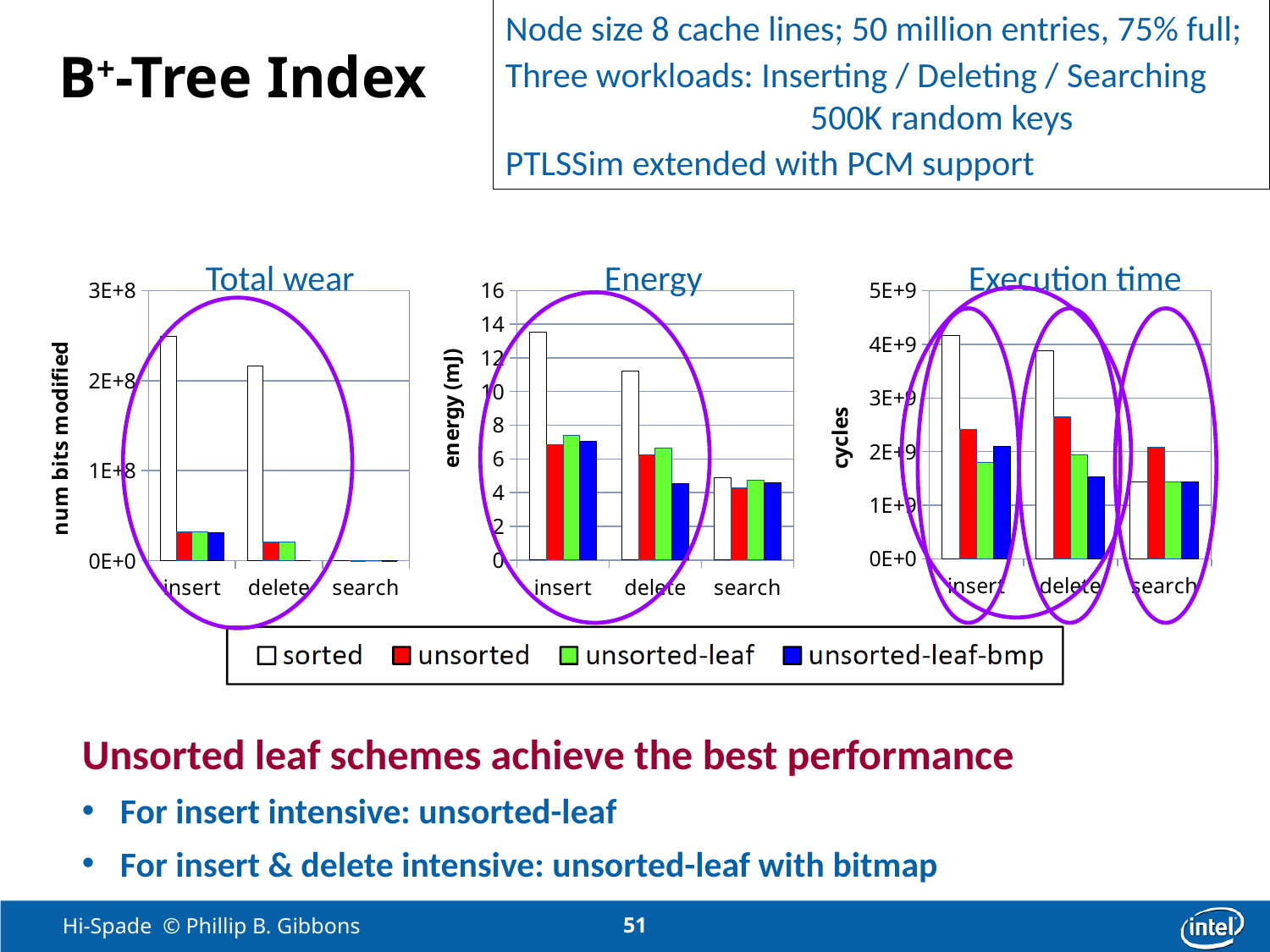
How many series does the shared legend list for the charts? 4 In the Execution time chart, which is larger for delete: unsorted or unsorted-leaf-bmp? unsorted In the Energy chart, is the value for sorted on insert greater or less than 12? greater In the Total wear chart, is the value for sorted on insert greater or less than 2E+8? greater In the Execution time chart, is the value for sorted on insert greater or less than 3E+9? greater How many categories are shown on the x axis of the Energy chart? 3 What is the y-axis label of the Total wear chart? num bits modified In the Energy chart, which series has the highest value for insert? sorted In the Execution time chart, which series has the highest value for search? unsorted In the Execution time chart, which series has the lowest value for delete? unsorted-leaf-bmp What kind of chart is the Total wear chart? bar chart